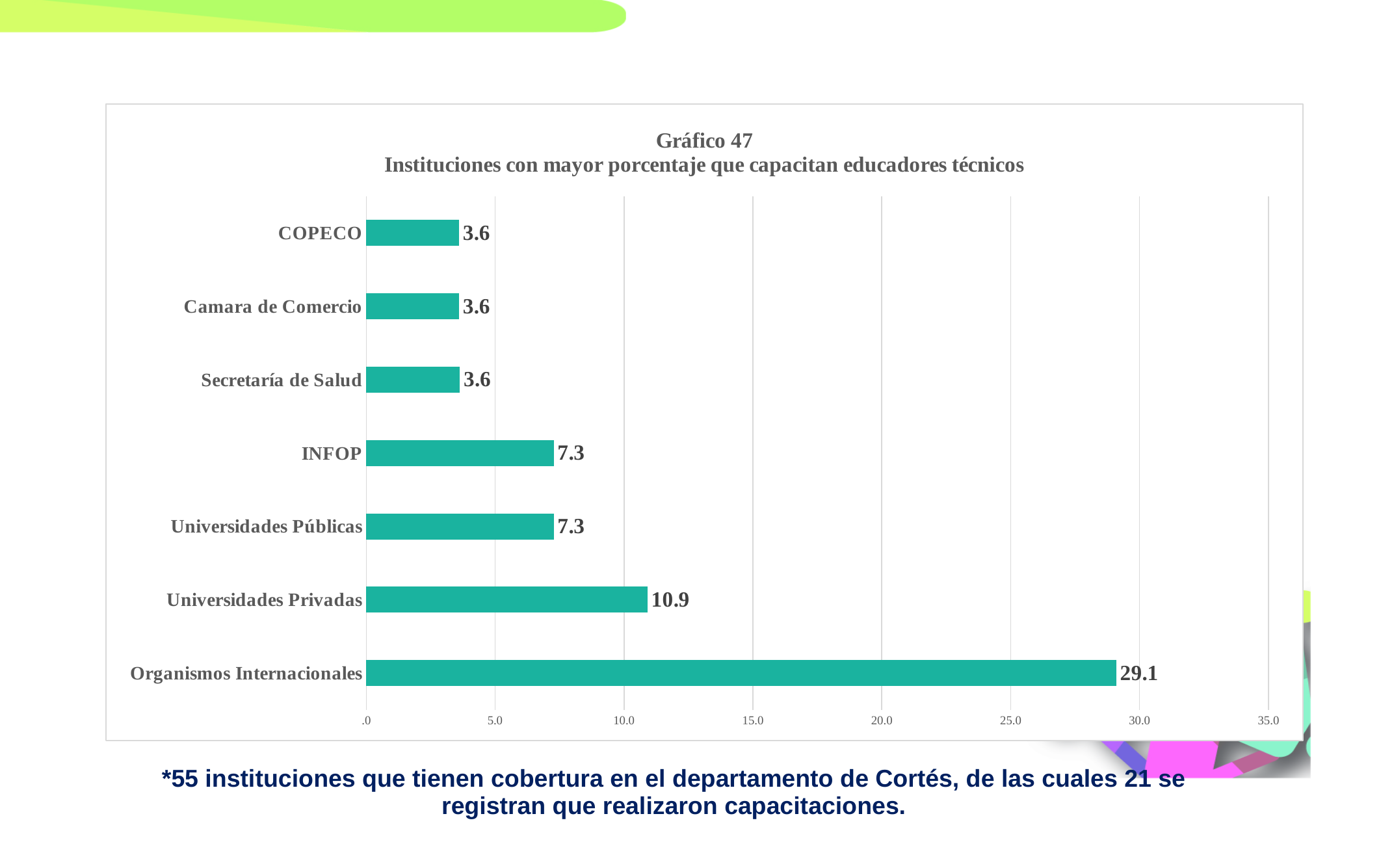
What is the difference between the values for Organismos Internacionales and Universidades Privadas? 18.2 Is the value for Organismos Internacionales greater or less than 25.0? greater Which is larger, the value for Universidades Privadas or the value for INFOP? Universidades Privadas What is the difference between the values for Universidades Privadas and Universidades Públicas? 3.6 How many categories are shown in the chart? 7 What is the value for INFOP? 7.3 Which category has the highest value? Organismos Internacionales What is the number of the chart given in its title? Gráfico 47 What kind of chart is shown on the slide? bar chart What is the value for Organismos Internacionales? 29.1 What is the value for COPECO? 3.6 What is the value for Universidades Privadas? 10.9